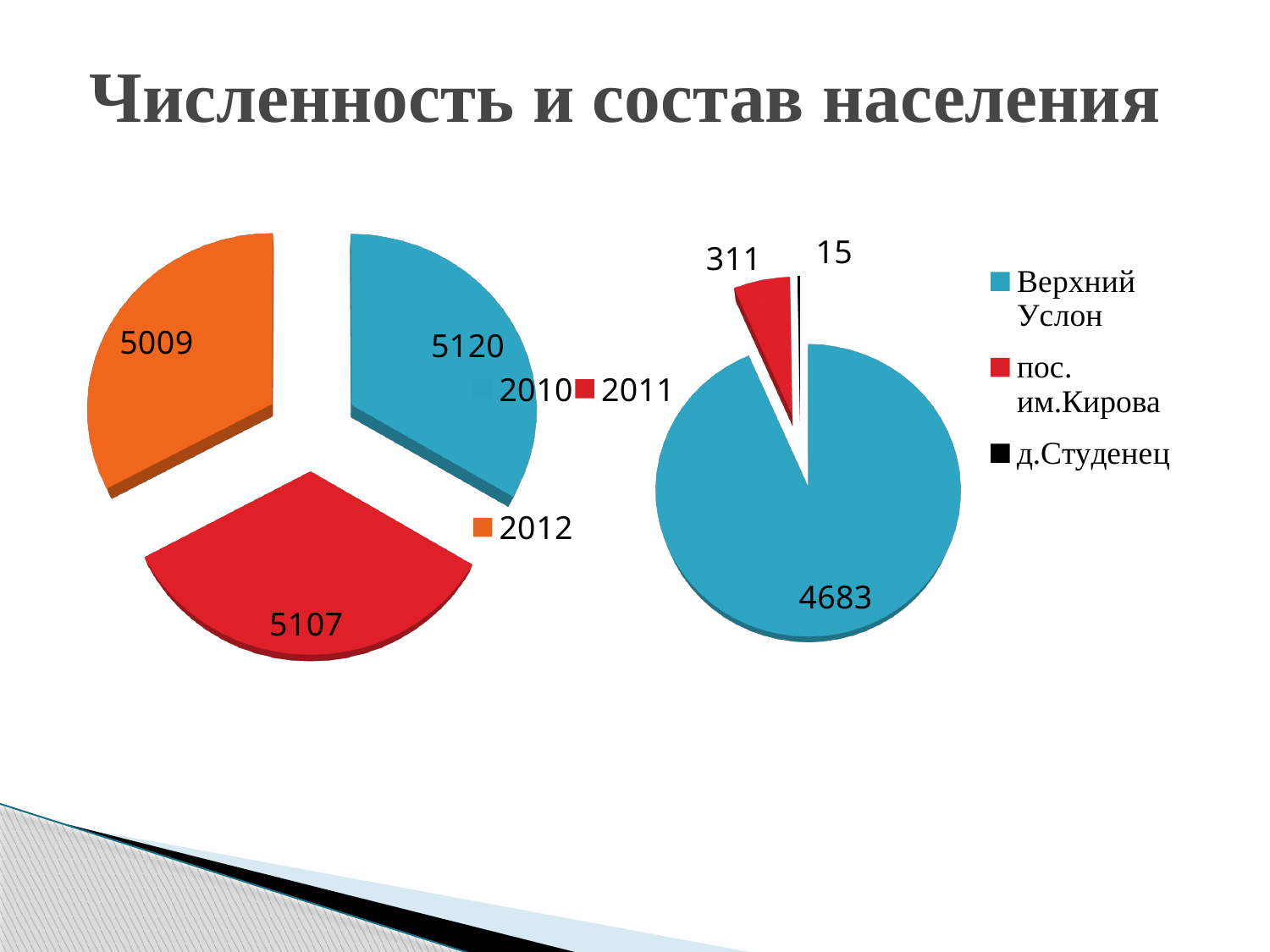
On the left pie chart, what is the difference between the values for 2010 and 2012? 111 On the right pie chart, what is the total of all three slices? 5009 On the left pie chart, which year has the highest value? 2010 On the left pie chart, what is the value for 2010? 5120 On the left pie chart, which year has the lowest value? 2012 On the left pie chart, how many slices are there? 3 On the left pie chart, what is the value for 2012? 5009 On the right pie chart, which is larger: пос. им.Кирова or д.Студенец? пос. им.Кирова On the right pie chart, which category has the largest slice? Верхний Услон On the right pie chart, what is the value for пос. им.Кирова? 311 What kind of chart is the chart on the left? Pie chart On the right pie chart, what is the value for д.Студенец? 15